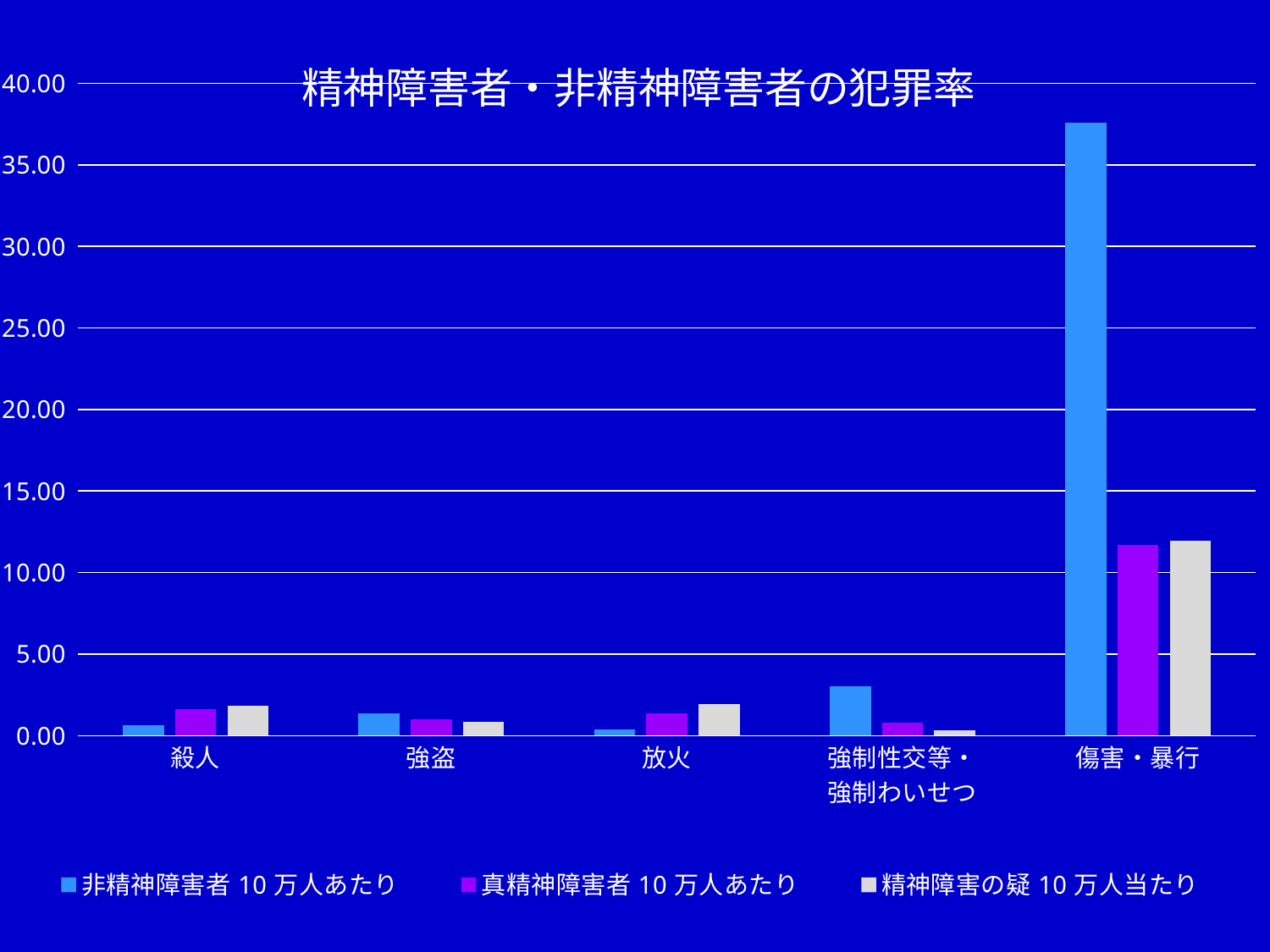
For 傷害・暴行, which is larger: the 非精神障害者 10 万人あたり value or the 真精神障害者 10 万人あたり value? 非精神障害者 10 万人あたり What is the title of the chart? 精神障害者・非精神障害者の犯罪率 Is the value for 傷害・暴行 in the 真精神障害者 10 万人あたり series greater or less than 15.00? less How many categories are shown on the x axis? 5 For 強制性交等・強制わいせつ, which is larger: the 非精神障害者 10 万人あたり value or the 精神障害の疑 10 万人当たり value? 非精神障害者 10 万人あたり Is the value for 傷害・暴行 in the 非精神障害者 10 万人あたり series greater or less than 35.00? greater Which category has the highest value for the 非精神障害者 10 万人あたり series? 傷害・暴行 For 殺人, which is larger: the 非精神障害者 10 万人あたり value or the 精神障害の疑 10 万人当たり value? 精神障害の疑 10 万人当たり How many series does the legend list? 3 Is the value for 傷害・暴行 in the 精神障害の疑 10 万人当たり series greater or less than 10.00? greater What kind of chart is shown on the slide? bar chart